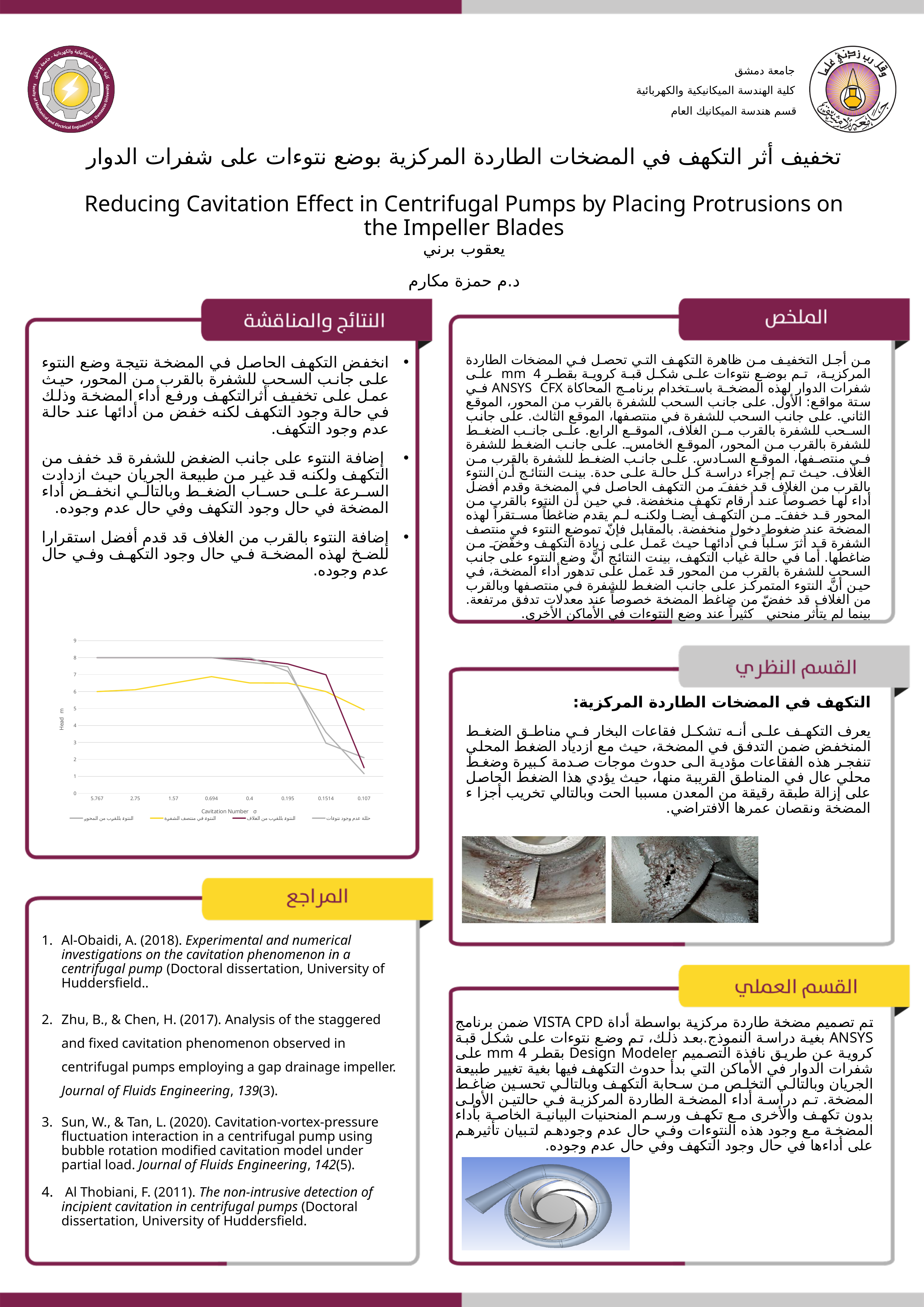
Is the value of the yellow series (النتوء في منتصف الشفرة) at cavitation number 5.767 greater or less than 5? greater At cavitation number 5.767, which is higher: the maroon series (النتوء بالقرب من الغلاف) or the yellow series (النتوء في منتصف الشفرة)? النتوء بالقرب من الغلاف What is the title of the y axis of the chart? Head m Is the value of the maroon series (النتوء بالقرب من الغلاف) at cavitation number 0.1514 greater or less than 6? greater Is the value of the maroon series (النتوء بالقرب من الغلاف) at cavitation number 0.107 greater or less than 2? less Which series has the highest head value at cavitation number 0.107? النتوء في منتصف الشفرة How many cavitation number values are plotted along the x axis of the chart? 8 What is the title of the x axis of the chart? Cavitation Number σ What kind of chart is shown in the Results and Discussion section? line chart Does the maroon series (النتوء بالقرب من الغلاف) rise or fall overall from left to right along the x axis? fall How many series does the legend of the Head vs Cavitation Number chart list? 4